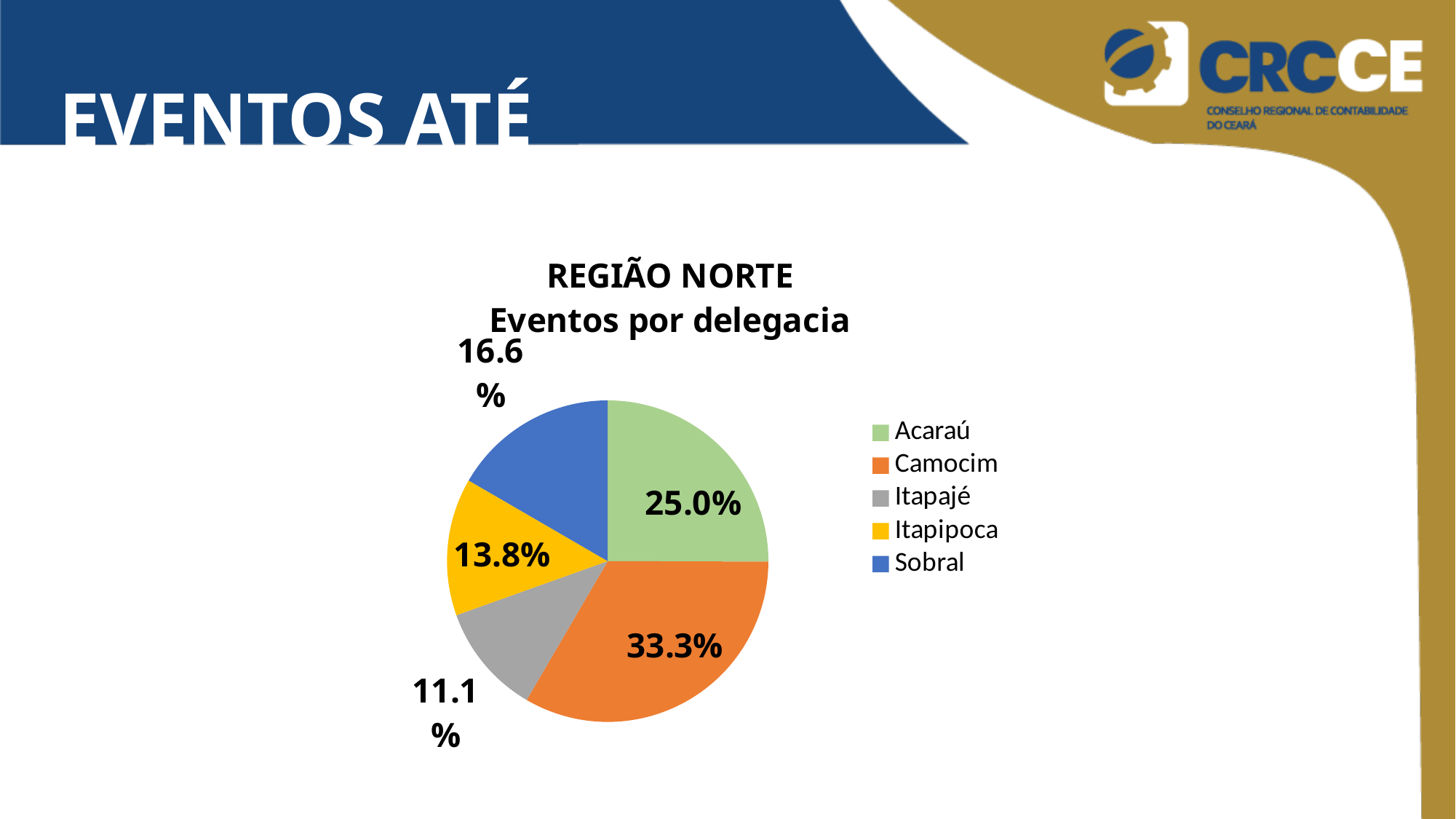
What is the share for Acaraú? 25.0% Which delegacia has the smallest share of events? Itapajé What is the share for Sobral? 16.6% What type of chart is shown on the slide? pie chart Which has a larger share, Sobral or Itapipoca? Sobral What is the title of the chart? REGIÃO NORTE Eventos por delegacia What is the share for Camocim? 33.3% Which delegacia has the largest share of events? Camocim What is the share for Itapipoca? 13.8% What is the difference between the shares of Camocim and Acaraú? 8.3% What is the share for Itapajé? 11.1% How many delegacias are shown in the pie chart? 5